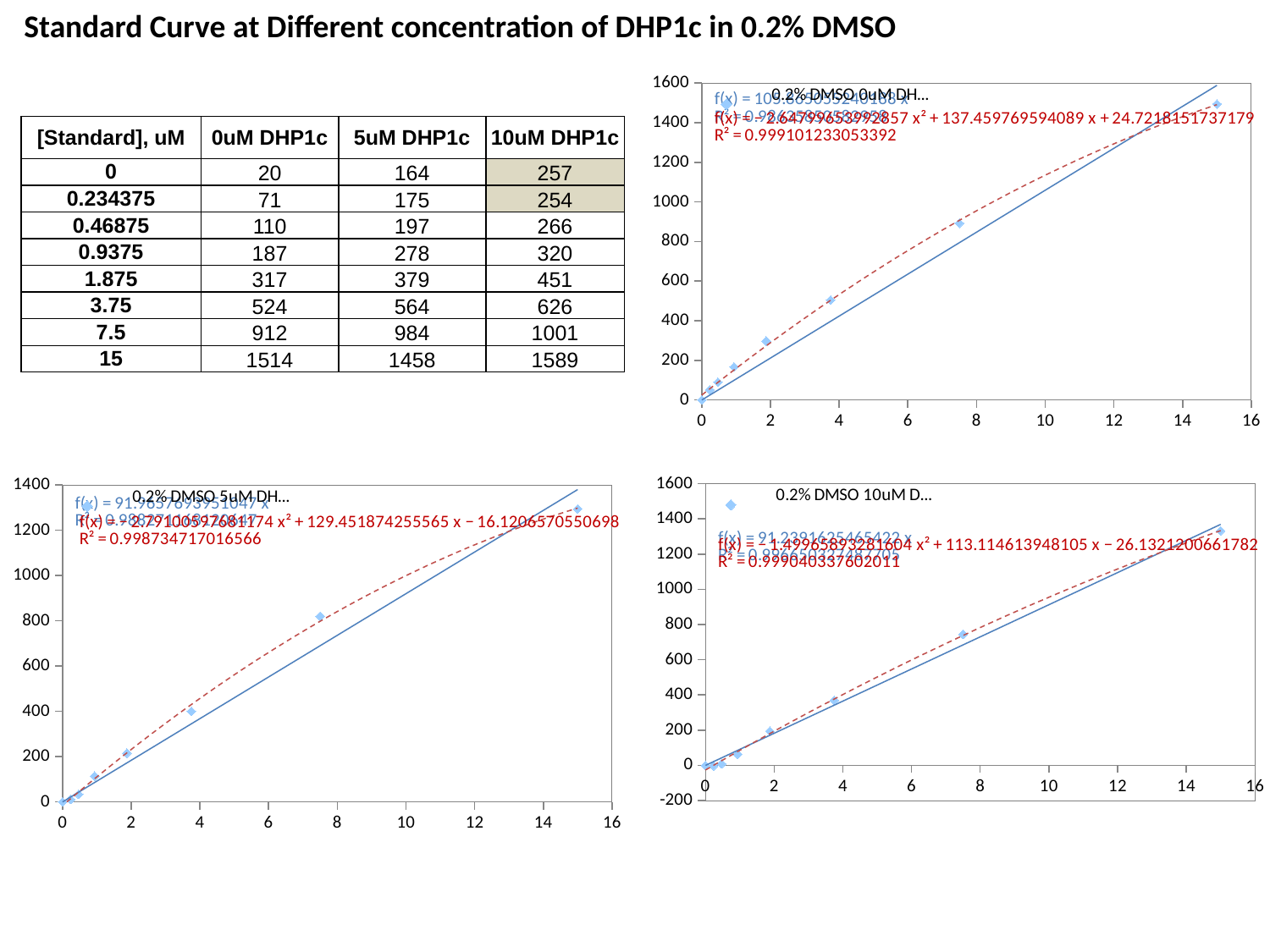
What kind of chart is the top-right chart titled "0.2% DMSO 0uM DH..."? Scatter chart In the top-right chart (0.2% DMSO 0uM DH...), is the value of the point at x = 7.5 greater or less than 800? greater In the bottom-left chart (0.2% DMSO 5uM DH...), is the value of the point at x = 15 greater or less than 1200? greater In the bottom-right chart (0.2% DMSO 10uM D...), is the value of the point at x = 7.5 greater or less than 800? less In the bottom-left chart (0.2% DMSO 5uM DH...), do the plotted values rise or fall as x increases? rise How many data points are plotted in the bottom-left chart (0.2% DMSO 5uM DH...)? 8 What is the R² value shown in red for the polynomial fit in the top-right chart (0.2% DMSO 0uM DH...)? 0.999101233053392